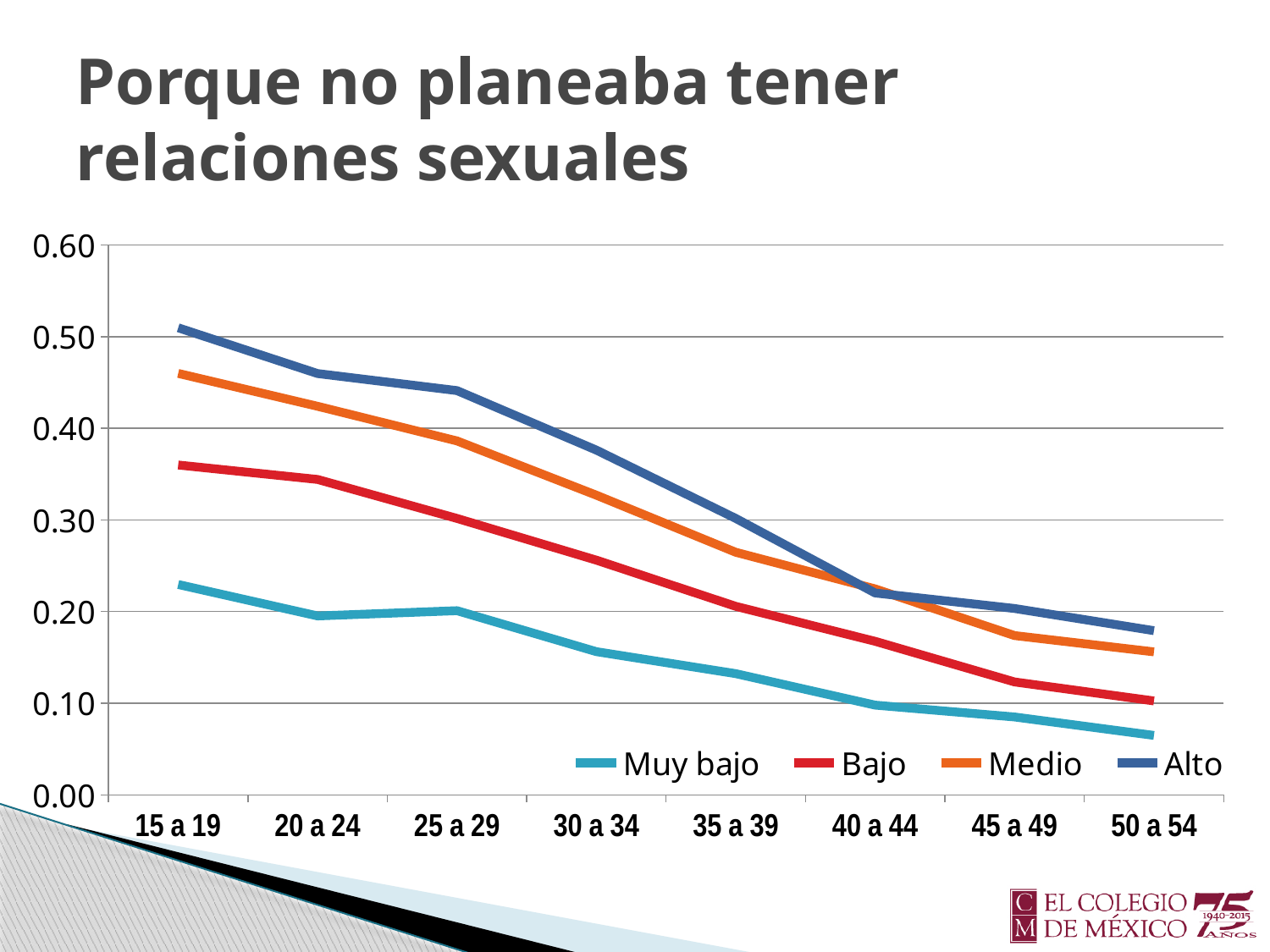
Does the Alto series rise or fall across the age groups from 15 a 19 to 50 a 54? fall Is the value for Medio at 45 a 49 greater or less than 0.20? less Is the value for Bajo at 15 a 19 greater or less than 0.30? greater What is the title of the chart? Porque no planeaba tener relaciones sexuales How many age groups are shown on the x axis? 8 Which series has the highest value for the 15 a 19 age group? Alto Which series has the lowest value for the 50 a 54 age group? Muy bajo Is the value for Alto at 15 a 19 greater or less than 0.40? greater Which is larger at 30 a 34, the value for Medio or the value for Bajo? Medio What kind of chart is shown on the slide? line chart How many series does the legend list? 4